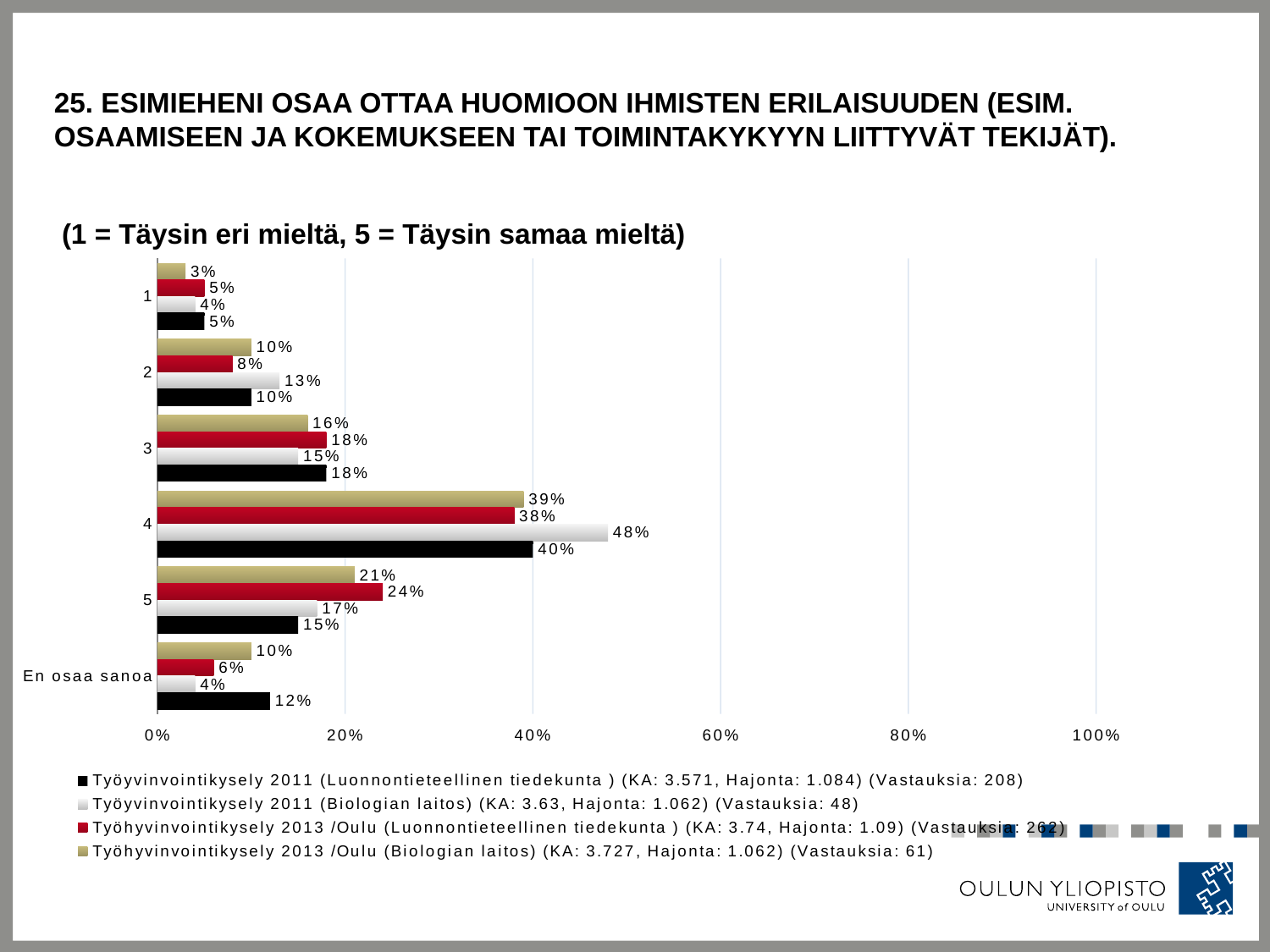
What kind of chart is shown on the slide? bar chart What is the value for category 5 in the Työhyvinvointikysely 2013 /Oulu (Luonnontieteellinen tiedekunta) series? 24% For category 5, which is larger: the Työhyvinvointikysely 2013 /Oulu (Luonnontieteellinen tiedekunta) value or the Työyvinvointikysely 2011 (Luonnontieteellinen tiedekunta) value? Työhyvinvointikysely 2013 /Oulu (Luonnontieteellinen tiedekunta) What is the value for category 1 in the Työhyvinvointikysely 2013 /Oulu (Biologian laitos) series? 3% How many series does the legend list? 4 What is the value for category 4 in the Työyvinvointikysely 2011 (Biologian laitos) series? 48% How many categories are shown on the vertical axis? 6 Which category has the lowest value in the Työhyvinvointikysely 2013 /Oulu (Biologian laitos) series? 1 What is the value for 'En osaa sanoa' in the Työyvinvointikysely 2011 (Luonnontieteellinen tiedekunta) series? 12% What is the difference between the Työyvinvointikysely 2011 (Biologian laitos) value and the Työyvinvointikysely 2011 (Luonnontieteellinen tiedekunta) value for category 4? 8% Is the value for category 4 in the Työyvinvointikysely 2011 (Biologian laitos) series greater or less than 40%? greater Which category has the highest value in the Työyvinvointikysely 2011 (Biologian laitos) series? 4